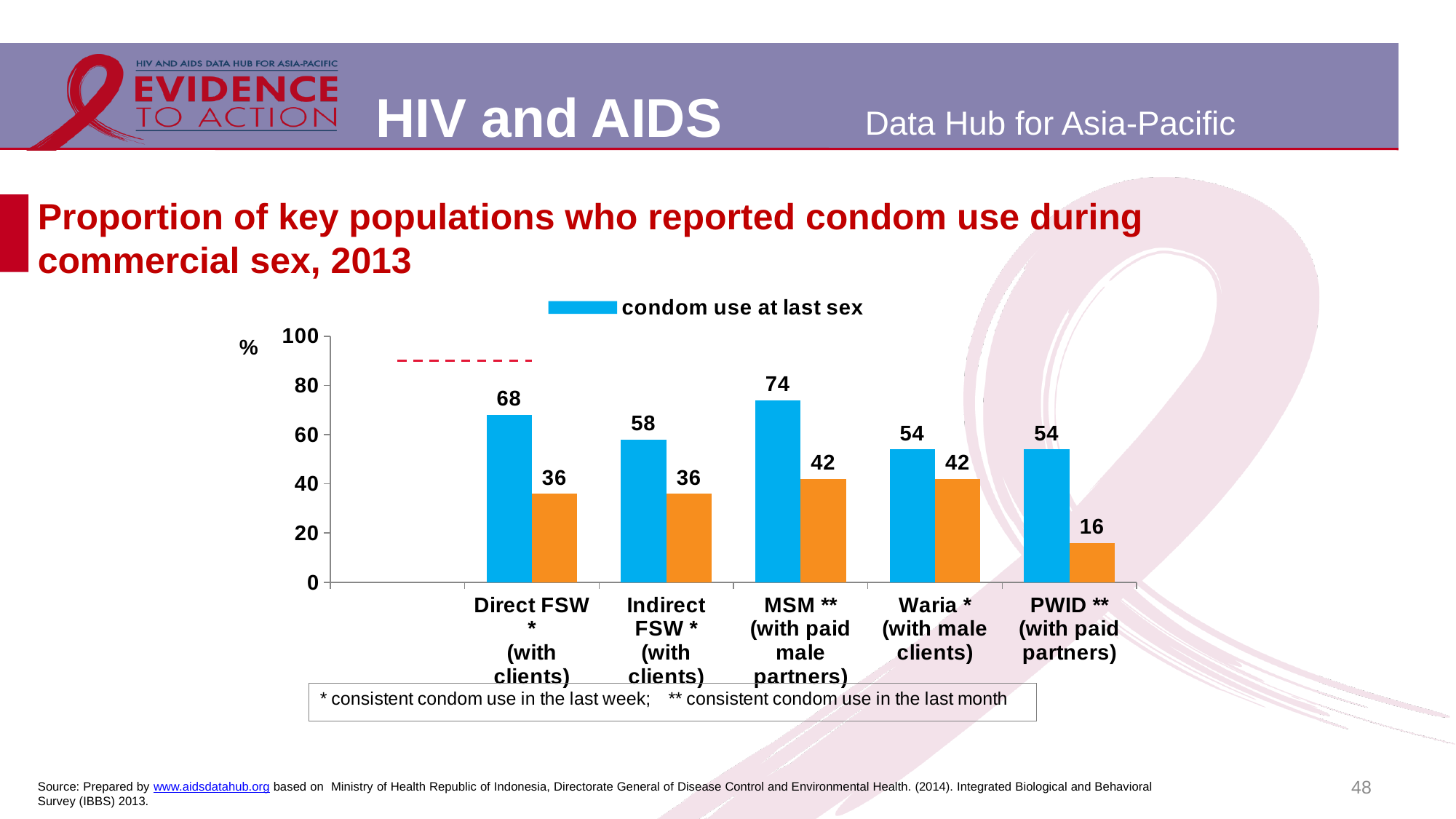
How many key population categories are shown on the x axis? 5 What kind of chart is shown on the slide? bar chart What colour are the bars for the legend entry 'condom use at last sex'? blue What is the value of condom use at last sex for Indirect FSW * (with clients)? 58 Which has a higher value for condom use at last sex: Direct FSW * (with clients) or Indirect FSW * (with clients)? Direct FSW * (with clients) Which key population has the lowest orange bar value? PWID ** (with paid partners) What is the difference between the condom use at last sex values for MSM ** (with paid male partners) and Waria * (with male clients)? 20 What is the value of the orange bar for PWID ** (with paid partners)? 16 For Direct FSW * (with clients), what is the difference between the condom use at last sex value and the orange bar value? 32 Which key population has the highest value for condom use at last sex? MSM ** (with paid male partners) What is the value of condom use at last sex for MSM ** (with paid male partners)? 74 Is the condom use at last sex value for Waria * (with male clients) greater or less than 60? less